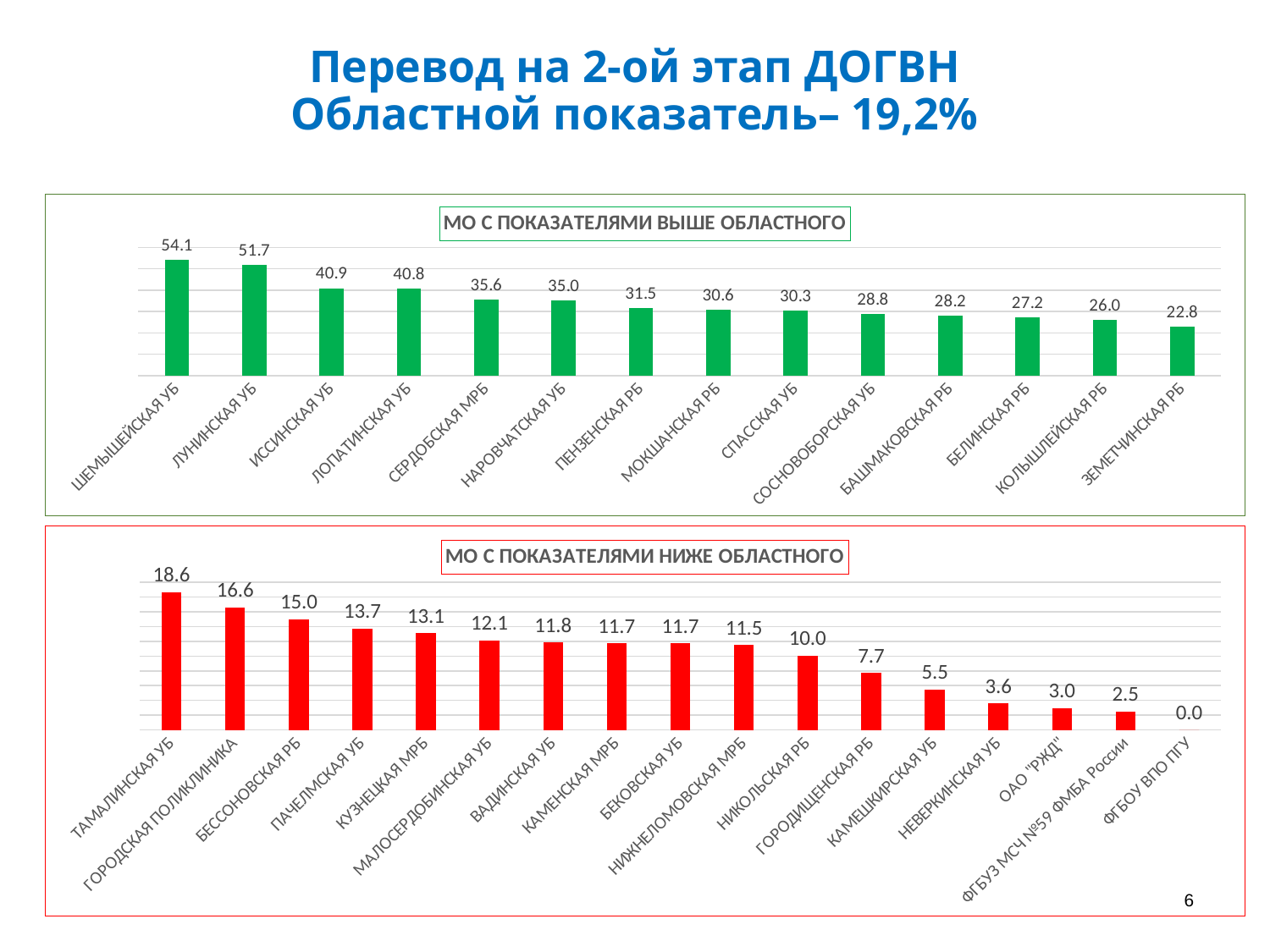
In the top chart (МО С ПОКАЗАТЕЛЯМИ ВЫШЕ ОБЛАСТНОГО), what is the difference between the values for Шемышейская УБ and Лунинская УБ? 2.4 In the bottom chart (МО С ПОКАЗАТЕЛЯМИ НИЖЕ ОБЛАСТНОГО), which category has the highest value? Тамалинская УБ What type of chart is the bottom chart (МО С ПОКАЗАТЕЛЯМИ НИЖЕ ОБЛАСТНОГО)? bar chart In the top chart (МО С ПОКАЗАТЕЛЯМИ ВЫШЕ ОБЛАСТНОГО), do the values rise or fall from left to right? fall In the bottom chart (МО С ПОКАЗАТЕЛЯМИ НИЖЕ ОБЛАСТНОГО), which is larger: the value for Городищенская РБ or the value for Камешкирская УБ? Городищенская РБ In the top chart (МО С ПОКАЗАТЕЛЯМИ ВЫШЕ ОБЛАСТНОГО), how many categories are plotted? 14 In the top chart (МО С ПОКАЗАТЕЛЯМИ ВЫШЕ ОБЛАСТНОГО), which category has the highest value? Шемышейская УБ In the top chart (МО С ПОКАЗАТЕЛЯМИ ВЫШЕ ОБЛАСТНОГО), what is the value for Сердобская МРБ? 35.6 In the bottom chart (МО С ПОКАЗАТЕЛЯМИ НИЖЕ ОБЛАСТНОГО), what is the value for Никольская РБ? 10.0 In the top chart (МО С ПОКАЗАТЕЛЯМИ ВЫШЕ ОБЛАСТНОГО), which category has the lowest value? Земетчинская РБ In the bottom chart (МО С ПОКАЗАТЕЛЯМИ НИЖЕ ОБЛАСТНОГО), how many categories are plotted? 17 In the bottom chart (МО С ПОКАЗАТЕЛЯМИ НИЖЕ ОБЛАСТНОГО), which category has the lowest value? ФГБОУ ВПО ПГУ